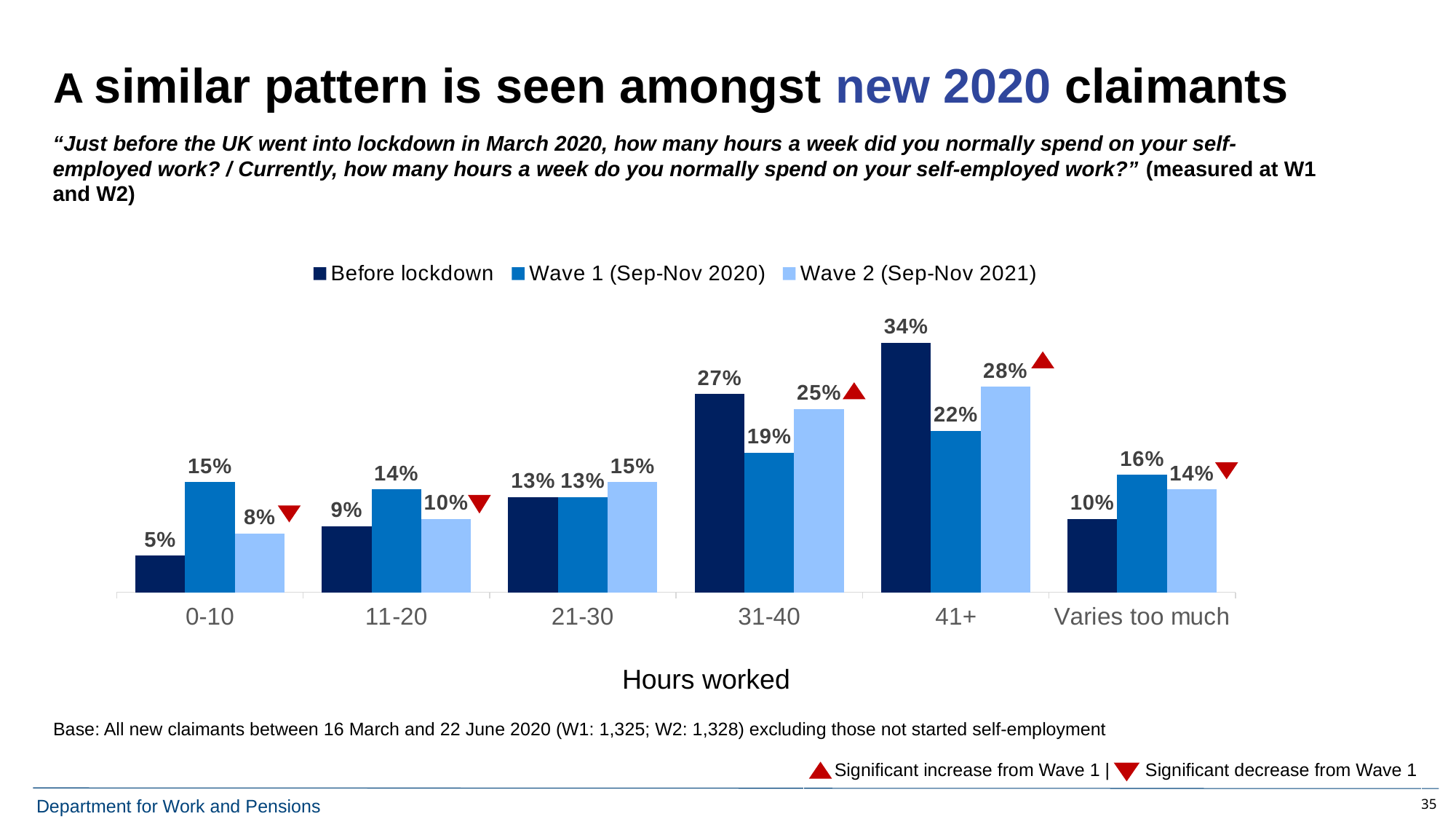
What does the red upward triangle next to a bar indicate? Significant increase from Wave 1 What is the x-axis title of the chart? Hours worked What kind of chart is shown on the slide? Bar chart Which hours-worked category has the highest Before lockdown value? 41+ What is the Wave 2 (Sep-Nov 2021) value for the 0-10 hours category? 8% What is the Wave 1 (Sep-Nov 2020) value for the 31-40 hours category? 19% How many hours-worked categories are shown on the x axis? 6 How many series does the legend list? 3 Which is larger for the 31-40 category: the Wave 1 value or the Wave 2 value? Wave 2 (Sep-Nov 2021) Which hours-worked category has the lowest Before lockdown value? 0-10 What is the Before lockdown value for the 41+ hours category? 34% What is the difference between the Before lockdown and Wave 1 values for the 41+ category? 12%